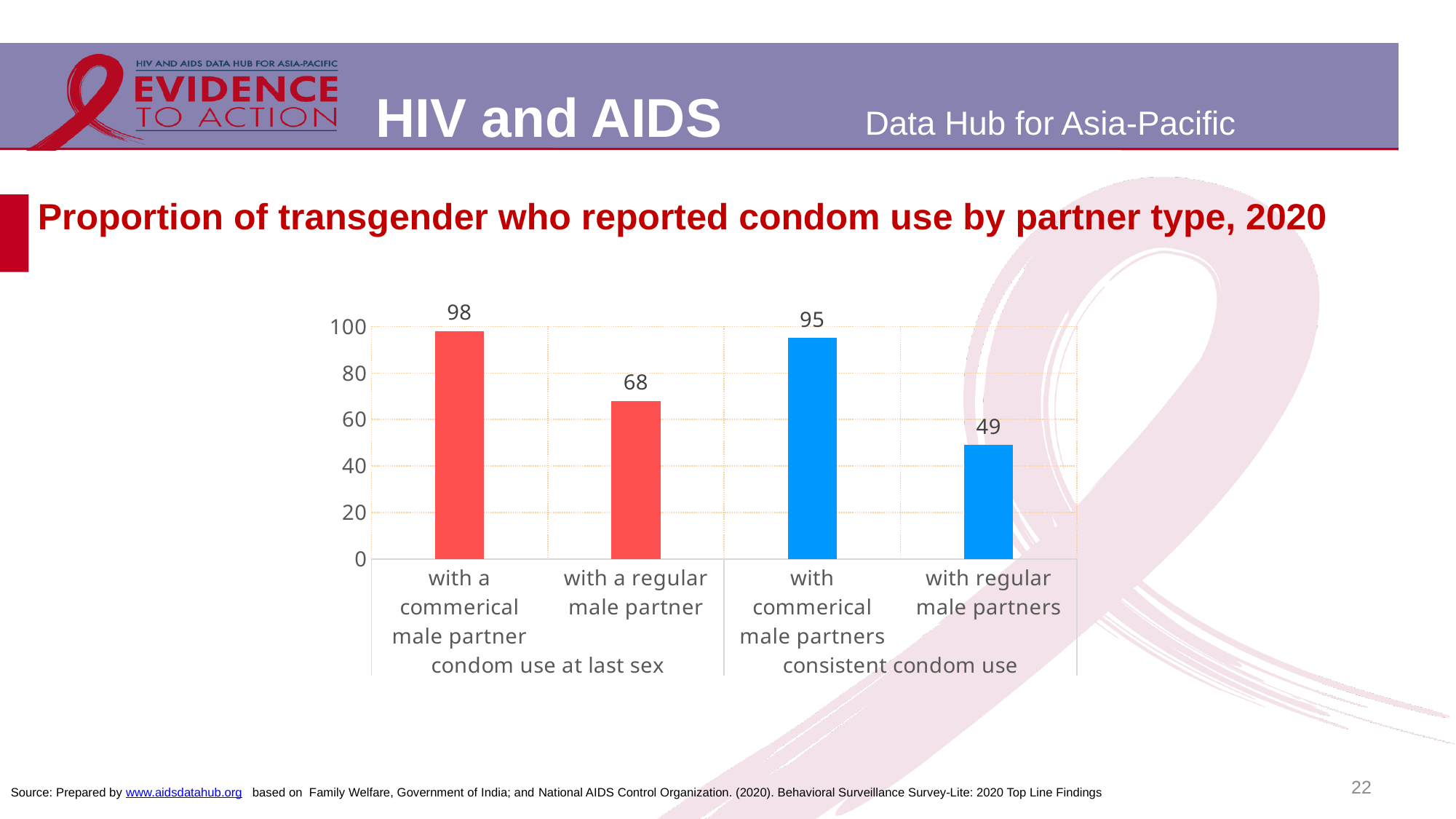
How many bars are shown in the chart? 4 What colour are the bars for consistent condom use? blue What is the value for condom use at last sex with a commercial male partner? 98 What is the value for consistent condom use with commercial male partners? 95 Which is larger: condom use at last sex with a regular male partner or consistent condom use with regular male partners? condom use at last sex with a regular male partner What is the difference between consistent condom use with commercial male partners and with regular male partners? 46 What is the value for consistent condom use with regular male partners? 49 What is the difference between condom use at last sex with a commercial male partner and with a regular male partner? 30 Which category has the lowest value? with regular male partners (consistent condom use) Which category has the highest value? with a commerical male partner (condom use at last sex) What kind of chart is shown on the slide? bar chart What is the value for condom use at last sex with a regular male partner? 68